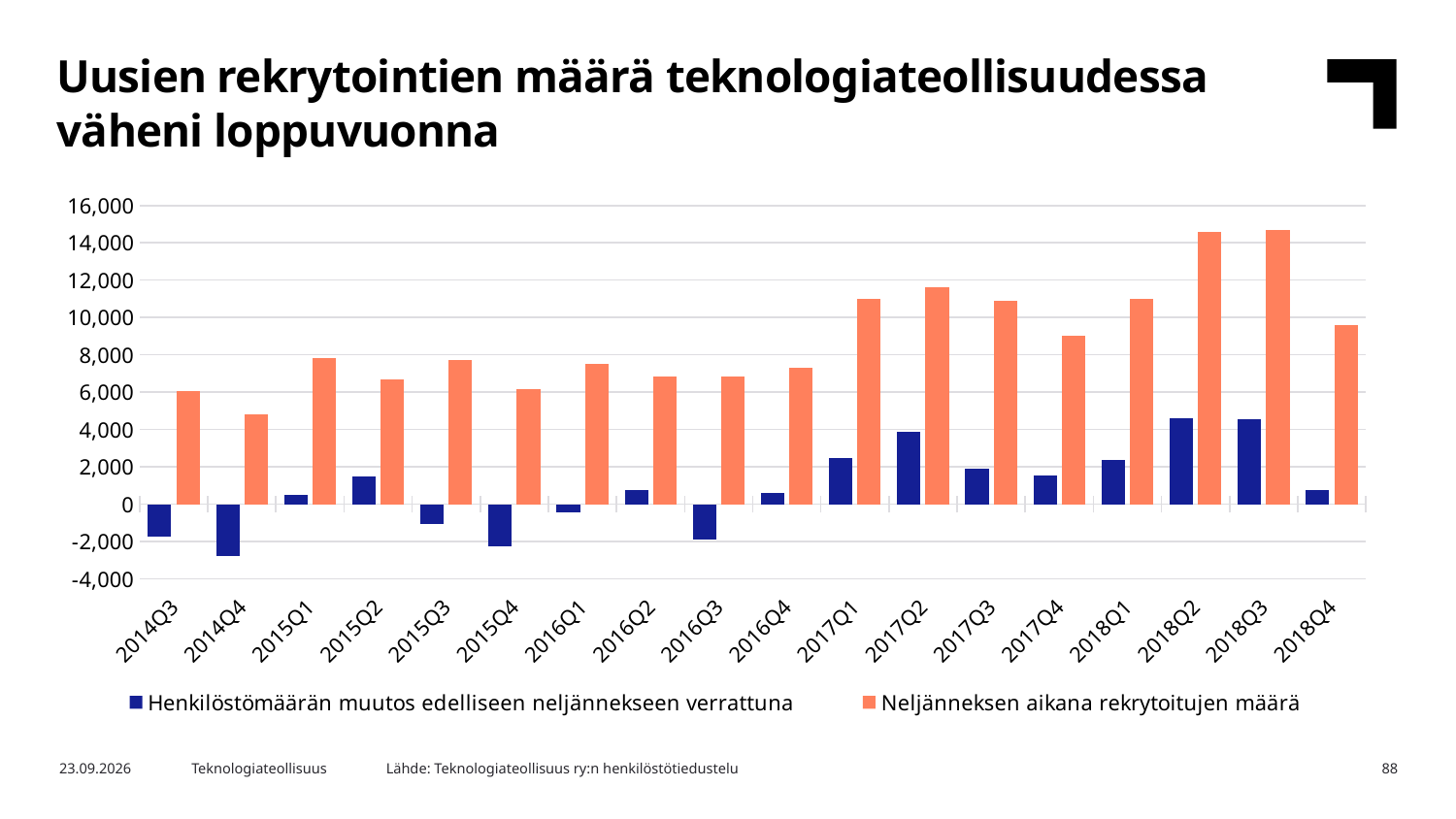
Is the value for 'Neljänneksen aikana rekrytoitujen määrä' in 2014Q4 greater or less than 6,000? less What kind of chart is shown on the slide? Bar chart Which quarter has the lowest value for 'Neljänneksen aikana rekrytoitujen määrä'? 2014Q4 Which series is shown in orange in the chart? Neljänneksen aikana rekrytoitujen määrä How many quarters are shown on the x axis of the chart? 18 Is the value for 'Henkilöstömäärän muutos edelliseen neljännekseen verrattuna' in 2014Q4 greater or less than -2,000? less Is the value for 'Henkilöstömäärän muutos edelliseen neljännekseen verrattuna' in 2018Q2 greater or less than 4,000? greater Which is larger, the value for 'Henkilöstömäärän muutos edelliseen neljännekseen verrattuna' in 2017Q1 or in 2016Q4? 2017Q1 Which is larger, the value for 'Neljänneksen aikana rekrytoitujen määrä' in 2017Q1 or in 2016Q4? 2017Q1 How many series does the chart's legend list? 2